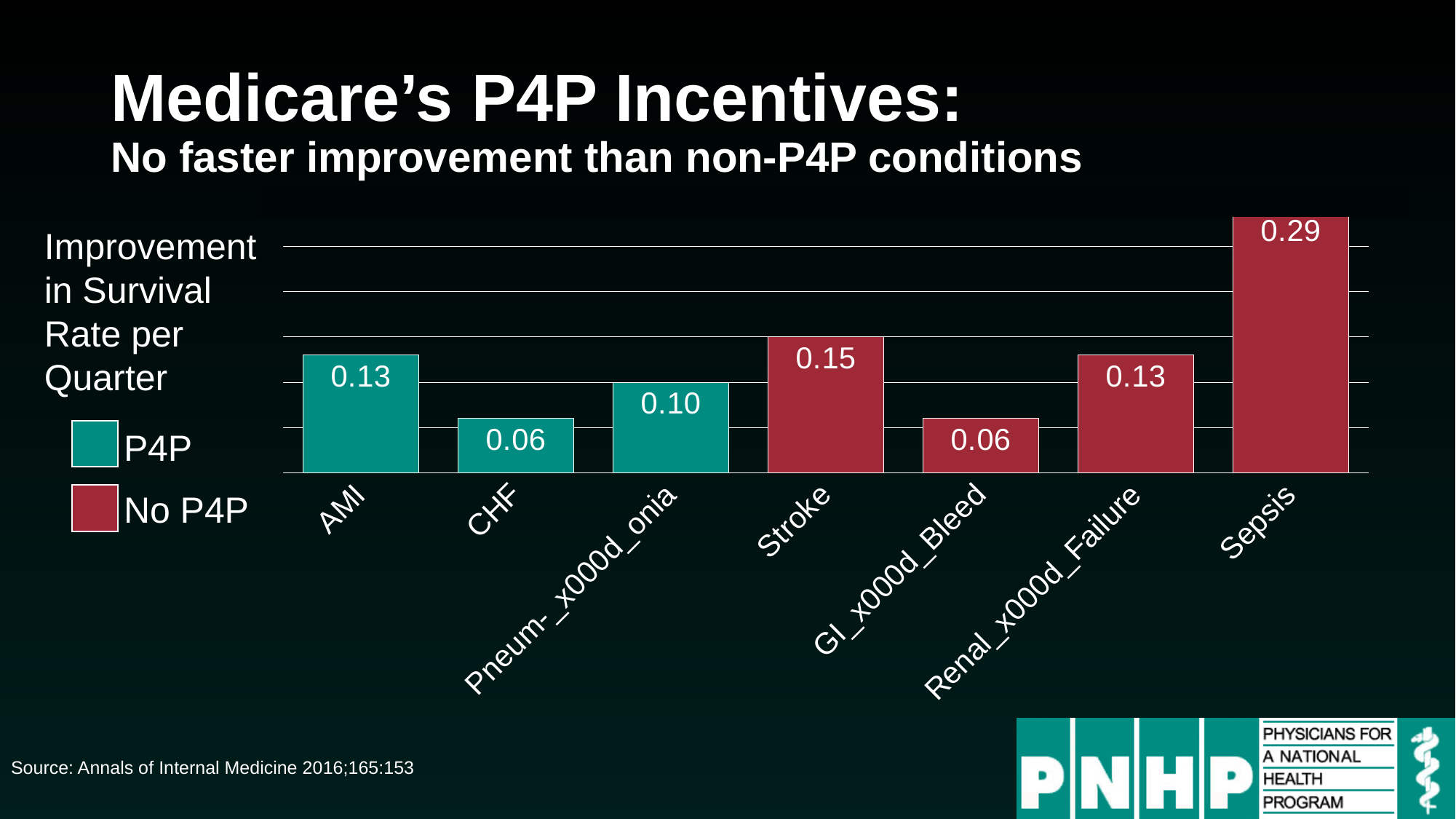
Which condition has the highest improvement in survival rate per quarter? Sepsis Which has a larger value, Stroke or Pneumonia? Stroke What is the difference between the values for Sepsis and Stroke? 0.14 What type of chart is shown on the slide? Bar chart What is the value shown for AMI? 0.13 What is the value shown for Stroke? 0.15 What is the value shown for CHF? 0.06 What is the improvement in survival rate per quarter for Sepsis? 0.29 What is the difference between the values for AMI and CHF? 0.07 How many series does the legend list? 2 How many conditions are shown on the chart? 7 What is the value shown for Pneumonia? 0.10